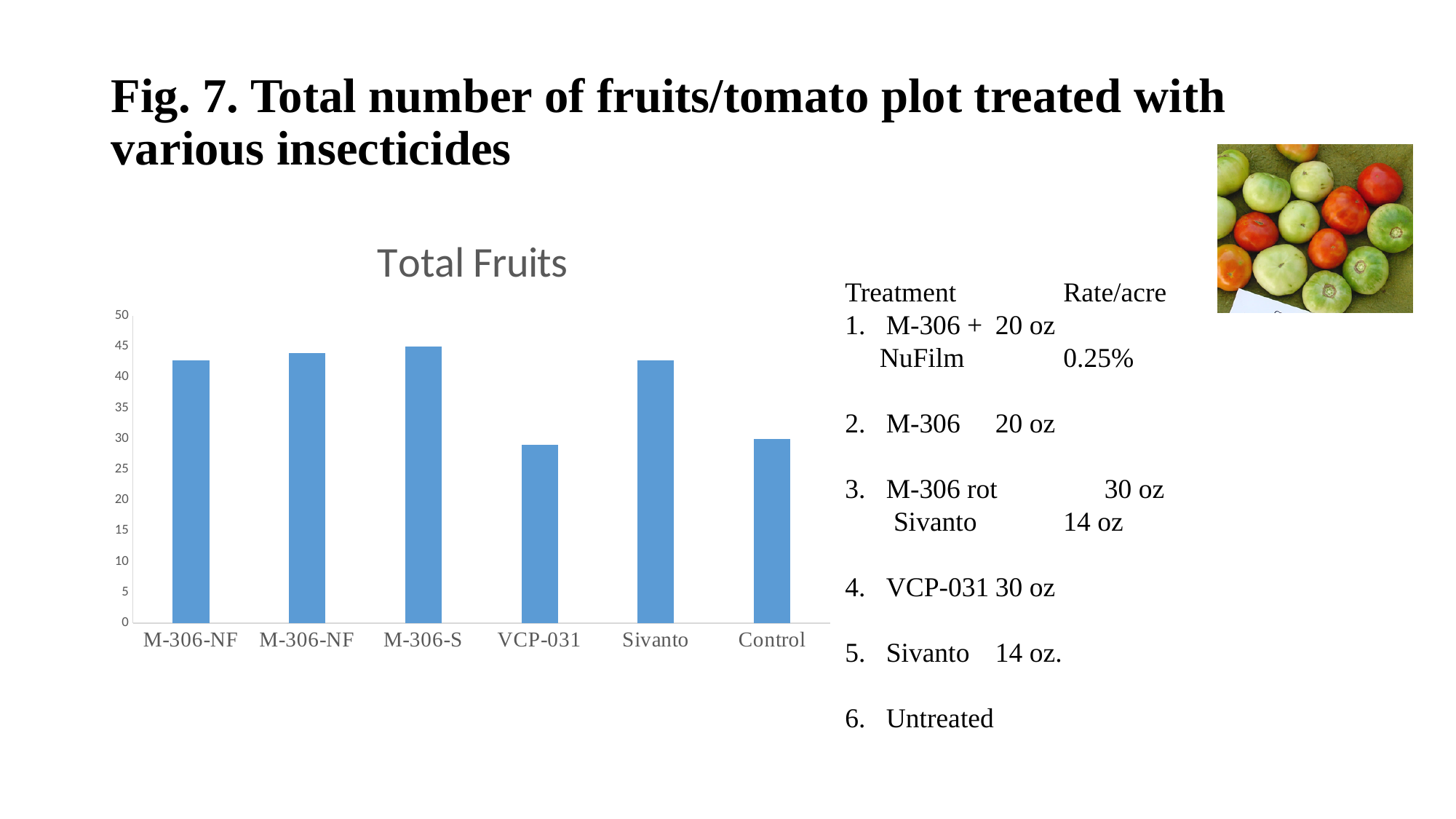
Which has the larger value, Sivanto or Control? Sivanto Is the value for M-306-S greater or less than 40? greater Which has the larger value, M-306-S or VCP-031? M-306-S Is the value for Sivanto greater or less than 40? greater Is the value for VCP-031 greater or less than 35? less What kind of chart is shown on the slide? bar chart How many categories are shown on the x axis of the chart? 6 Which has the larger value, Control or M-306-S? M-306-S What is the highest value shown on the y axis of the chart? 50 What is the title of the chart? Total Fruits